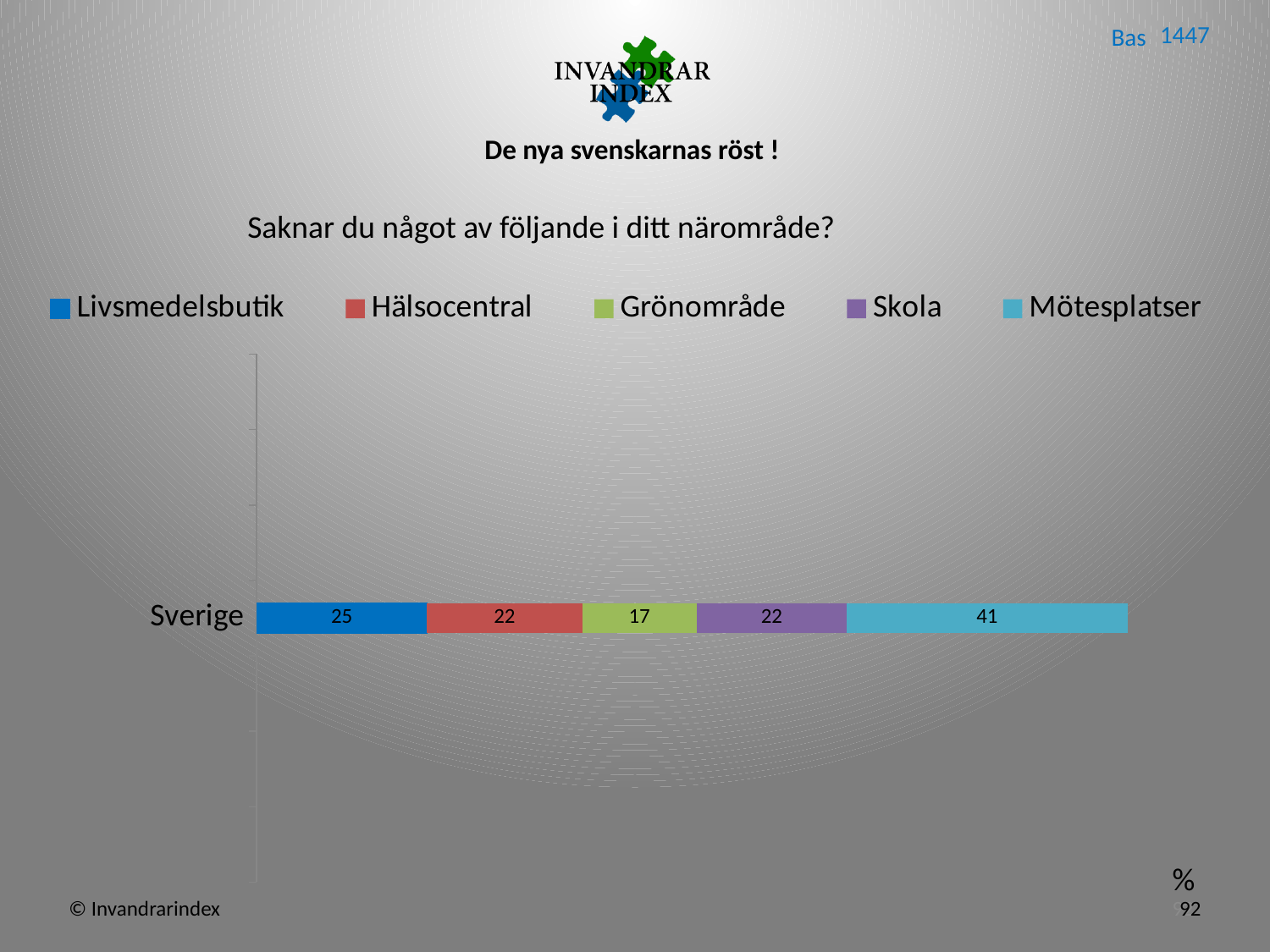
What is the value for Hälsocentral for Sverige? 22 What is the title of the chart? Saknar du något av följande i ditt närområde? Which is larger for Sverige, Livsmedelsbutik or Skola? Livsmedelsbutik What is the value for Mötesplatser for Sverige? 41 What is the difference between the Mötesplatser and Livsmedelsbutik values for Sverige? 16 What kind of chart is shown on the slide? Stacked bar chart What is the value for Livsmedelsbutik for Sverige? 25 Which series has the lowest value for Sverige? Grönområde What is the value for Grönområde for Sverige? 17 Which series has the highest value for Sverige? Mötesplatser What is the total of the stacked bar for Sverige? 127 How many series does the legend list? 5